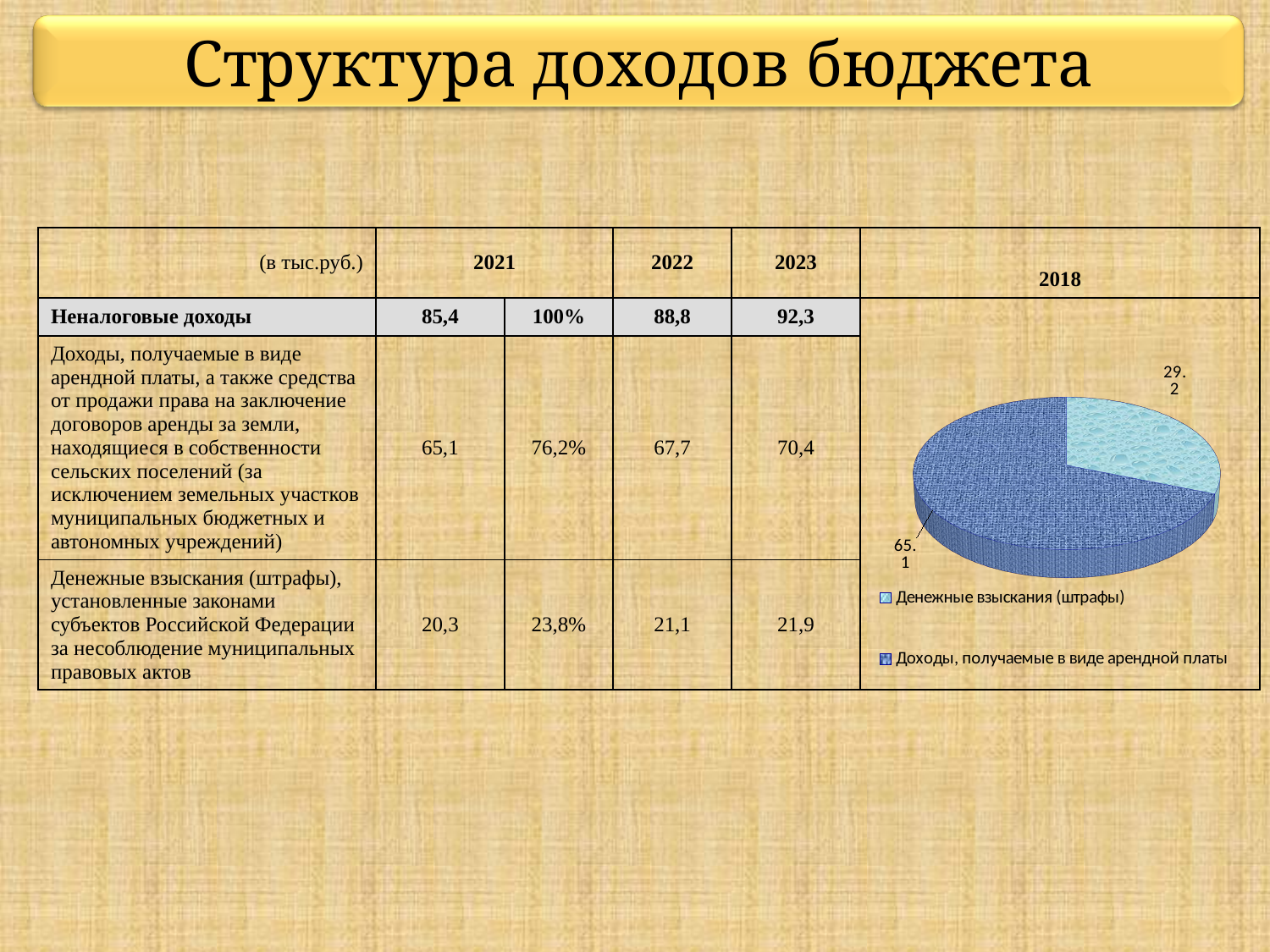
How many entries does the legend of the pie chart list? 2 What value is shown for the slice "Доходы, получаемые в виде арендной платы" in the pie chart? 65.1 What kind of chart is shown on the slide? pie chart How many slices does the pie chart have? 2 What is the difference between the two values shown in the pie chart, 65.1 and 29.2? 35.9 Which slice of the pie chart is the smallest? Денежные взыскания (штрафы) Which legend entry in the pie chart is shown in light blue? Денежные взыскания (штрафы) Which is larger in the pie chart: "Денежные взыскания (штрафы)" or "Доходы, получаемые в виде арендной платы"? Доходы, получаемые в виде арендной платы What is the title of the pie chart? 2018 Which slice of the pie chart is the largest? Доходы, получаемые в виде арендной платы What value is shown for the slice "Денежные взыскания (штрафы)" in the pie chart? 29.2